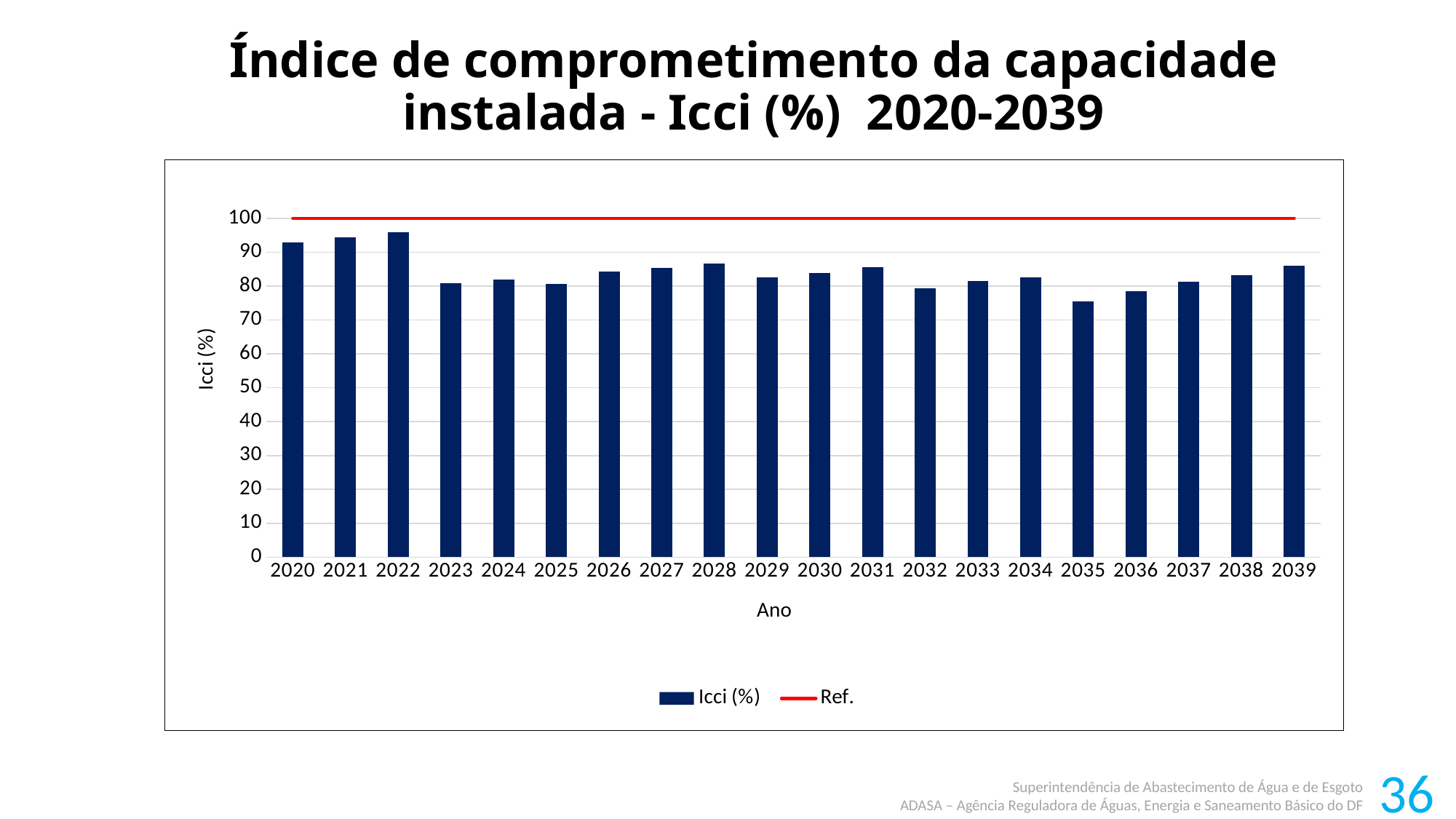
Is the Icci (%) value for 2022 greater or less than 100? less Is the Icci (%) value for 2035 greater or less than 80? less What kind of chart is shown on the slide? Combination bar and line chart (bars with a reference line) How many series does the legend list? 2 Which year has the highest Icci (%) value? 2022 Do the Icci (%) values rise or fall from 2020 to 2022? Rise What value does the Ref. line sit at? 100 Which year has the larger Icci (%) value, 2022 or 2023? 2022 How many years are shown on the x axis of the chart? 20 Which year has the larger Icci (%) value, 2035 or 2036? 2036 Is the Icci (%) value for 2020 greater or less than 90? greater Which year has the lowest Icci (%) value? 2035